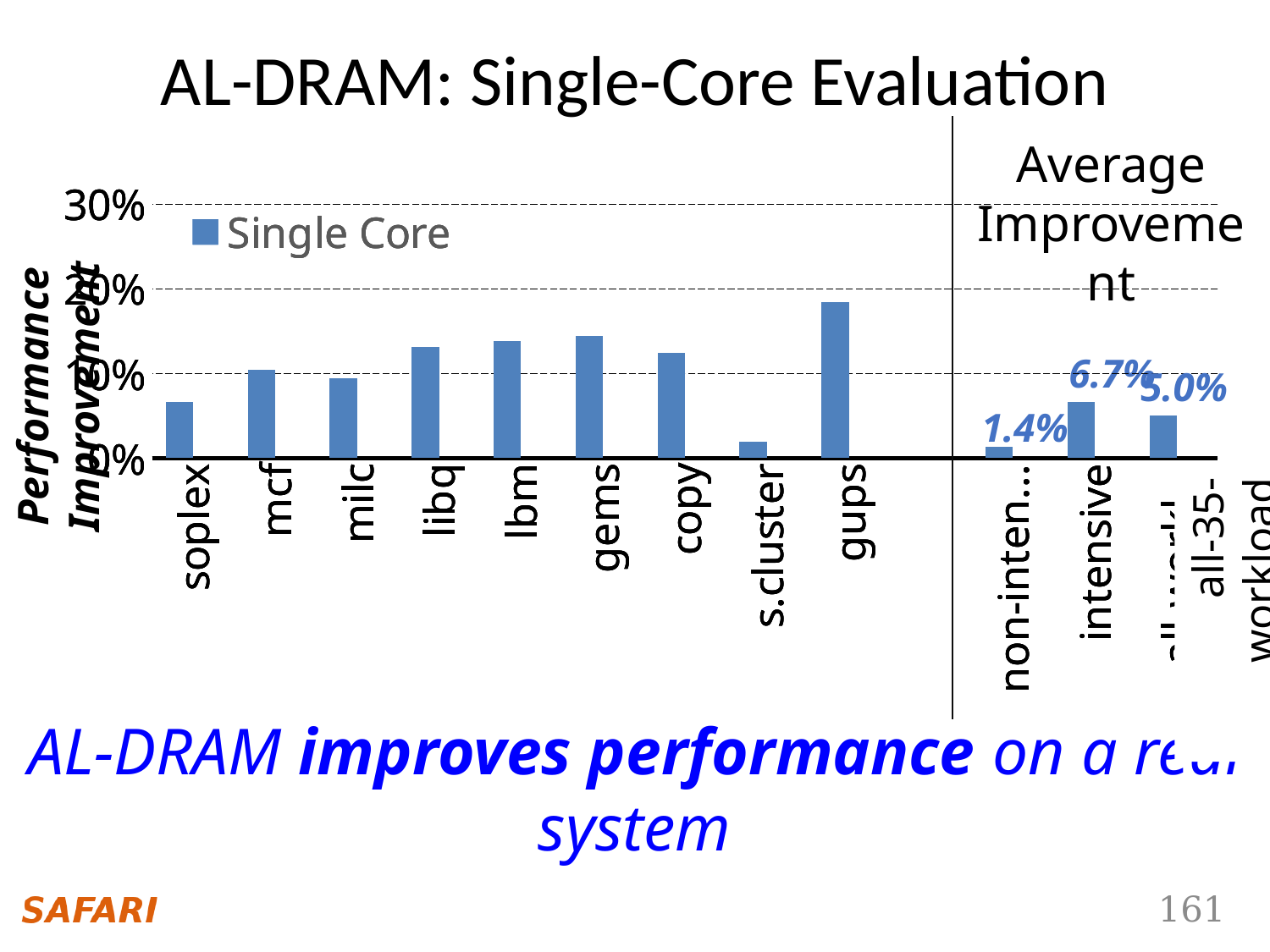
What is the difference between the average improvement for intensive workloads and for non-intensive workloads? 5.3% Which benchmark to the left of the vertical divider has the highest performance improvement? gups Is the performance improvement for s.cluster greater or less than 10%? less What kind of chart is shown on the slide? bar chart How many series does the legend list? 1 What is the average performance improvement for the intensive workloads? 6.7% Is the performance improvement for gups greater or less than 10%? greater Which has a larger performance improvement, gups or soplex? gups Which benchmark to the left of the vertical divider has the lowest performance improvement? s.cluster What is the average performance improvement for the non-intensive workloads? 1.4% How many individual benchmarks are plotted to the left of the vertical divider line? 9 What is the legend entry for the series in the chart? Single Core